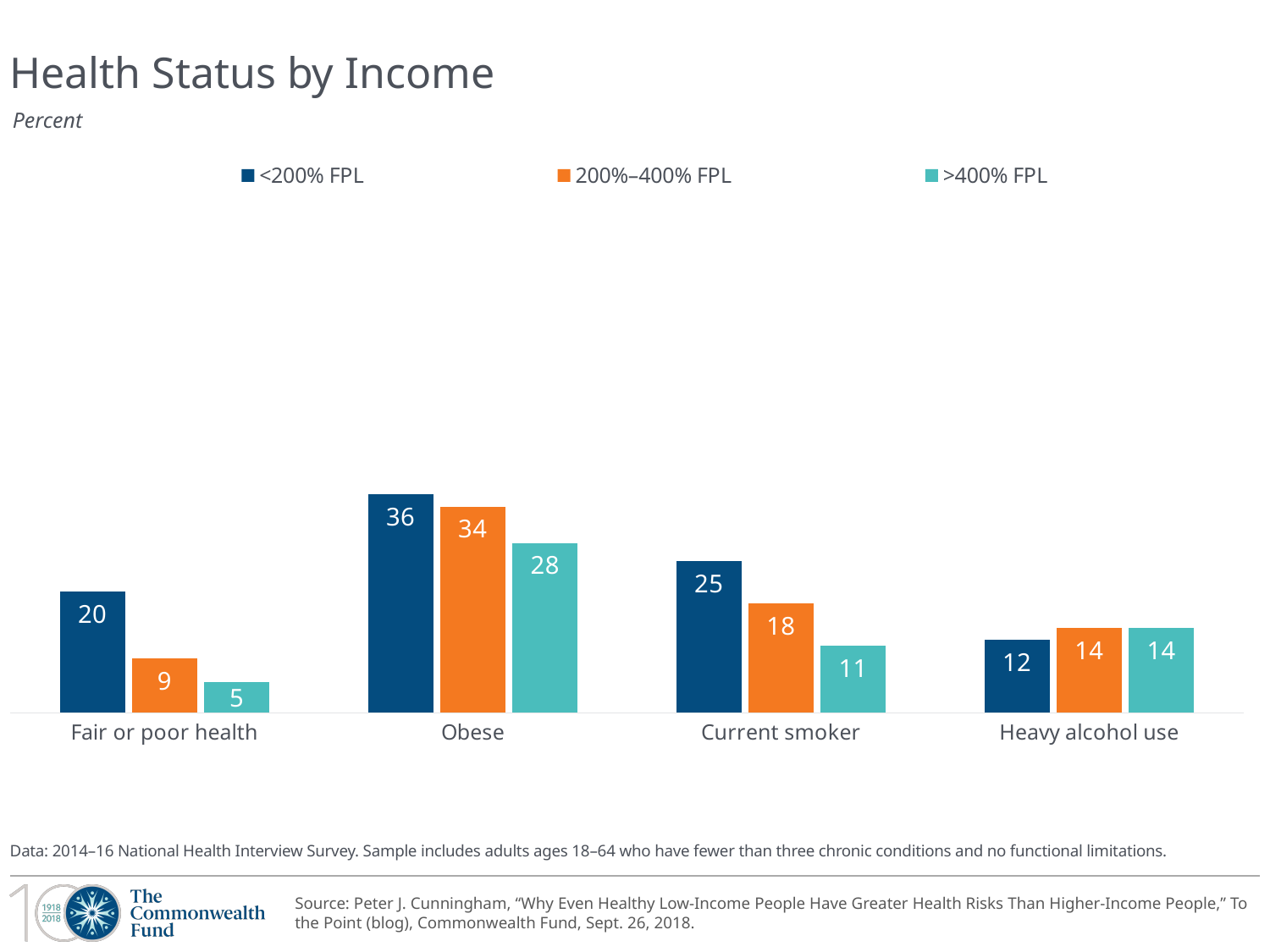
What is the value for 200%–400% FPL in the Current smoker category? 18 Which category has the highest value for the <200% FPL series? Obese In the Fair or poor health category, which is larger: the value for <200% FPL or the value for 200%–400% FPL? <200% FPL What is the value for >400% FPL in the Obese category? 28 What is the value for <200% FPL in the Heavy alcohol use category? 12 How many series does the legend list? 3 How many categories are shown on the x axis? 4 What is the value for <200% FPL in the Fair or poor health category? 20 Which category has the lowest value for the >400% FPL series? Fair or poor health What is the title of the chart? Health Status by Income What is the difference between the <200% FPL and >400% FPL values in the Current smoker category? 14 What kind of chart is shown on the slide? Bar chart